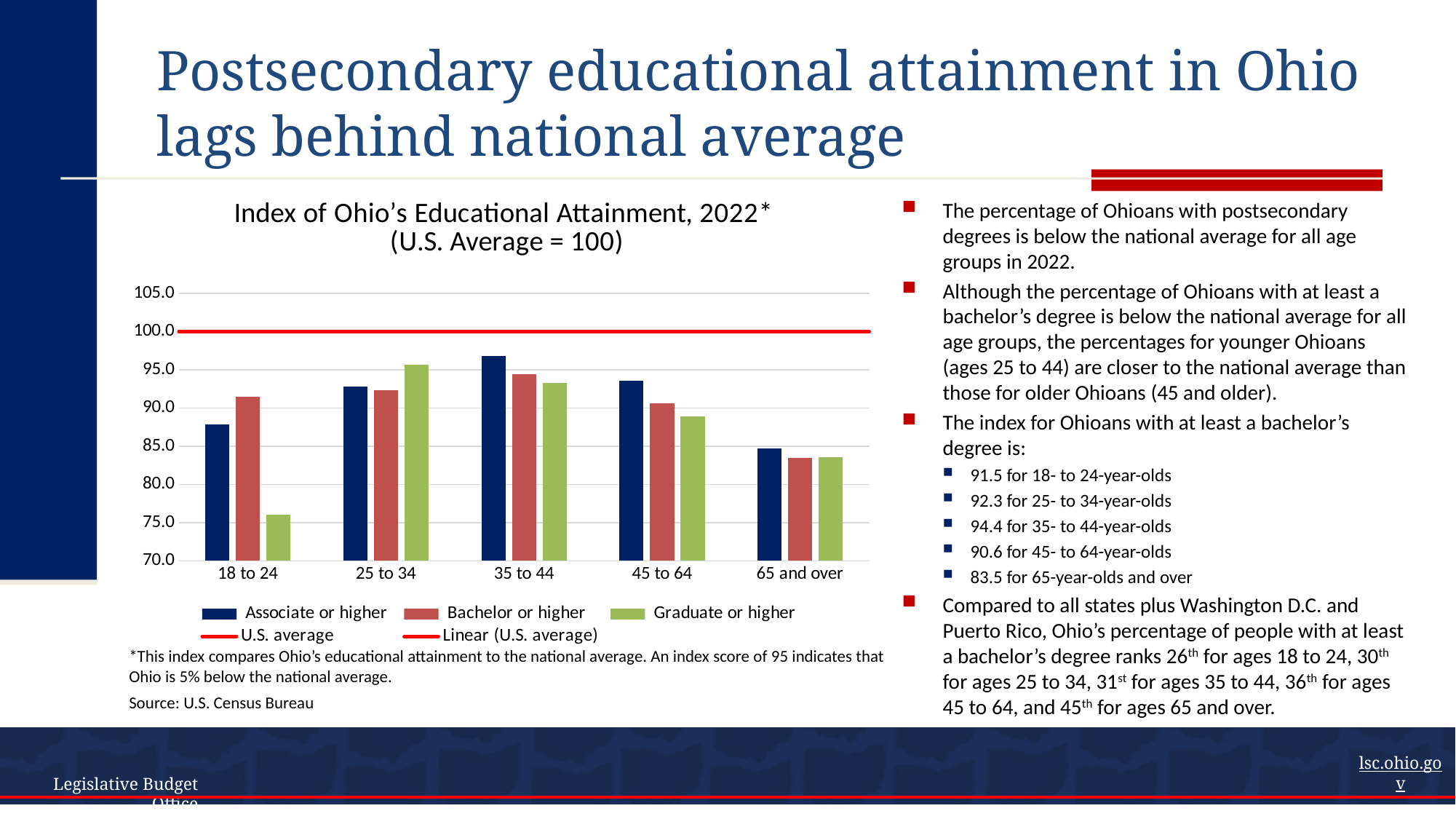
Which age group has the lowest Bachelor or higher index value? 65 and over What is the difference between the Bachelor or higher index values for the 35 to 44 and 65 and over age groups? 10.9 Is the Associate or higher value for the 35 to 44 age group greater or less than 95.0? greater What is the Bachelor or higher index value for the 35 to 44 age group? 94.4 Which is larger, the Bachelor or higher index value for 18 to 24 or for 45 to 64? 18 to 24 What kind of chart is used to show the Index of Ohio's Educational Attainment? Bar chart What is the Bachelor or higher index value for the 65 and over age group? 83.5 Is the Graduate or higher value for the 18 to 24 age group greater or less than 80.0? less How many age groups are shown on the x axis of the chart? 5 How many entries does the chart legend list? 5 What is the Bachelor or higher index value for the 18 to 24 age group? 91.5 Which age group has the highest Bachelor or higher index value? 35 to 44